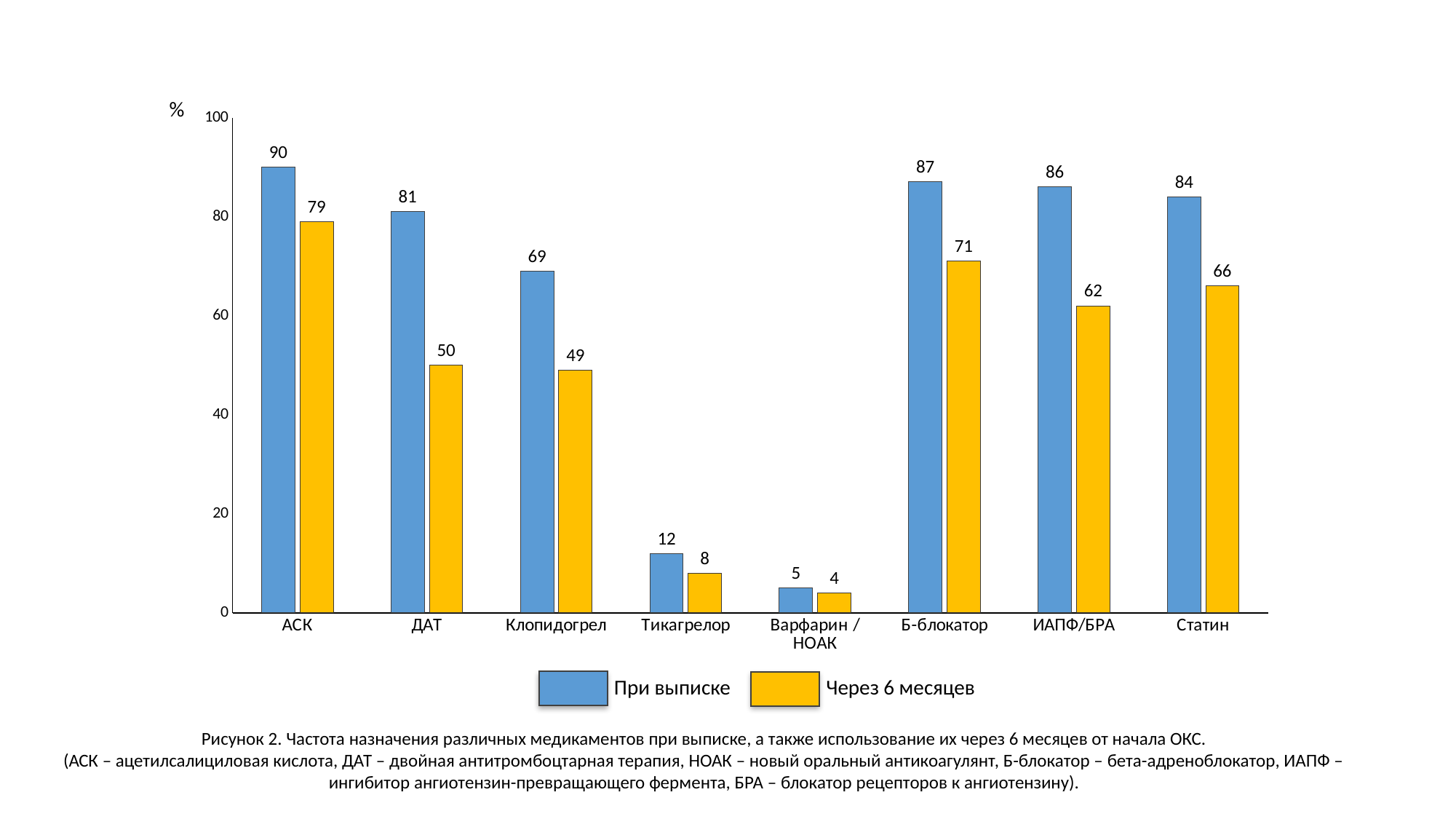
What is the value for Варфарин / НОАК in the 'При выписке' series? 5 Which colour represents the 'Через 6 месяцев' series? yellow How many categories are shown on the x axis? 8 What is the difference between the 'При выписке' and 'Через 6 месяцев' values for ДАТ? 31 Which category has the highest value in the 'При выписке' series? АСК What is the value for АСК in the 'При выписке' series? 90 How many series does the legend list? 2 What is the value for ИАПФ/БРА in the 'Через 6 месяцев' series? 62 Which category has the lowest value in the 'Через 6 месяцев' series? Варфарин / НОАК Is the 'Через 6 месяцев' value for Клопидогрел greater or less than 60? less Which is larger: the 'Через 6 месяцев' value for Б-блокатор or for Статин? Б-блокатор What kind of chart is shown on the slide? bar chart